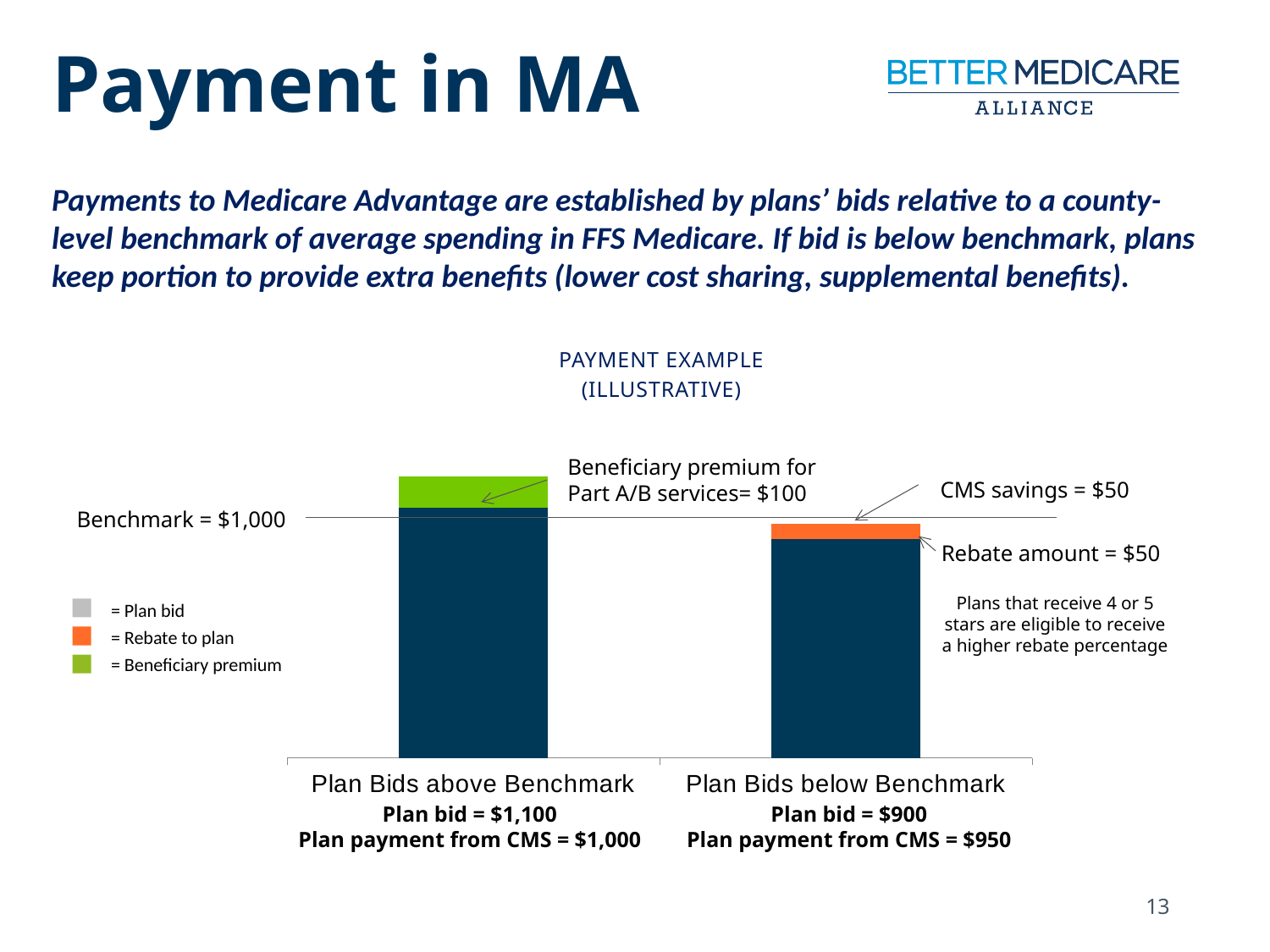
What is the title of the chart? PAYMENT EXAMPLE (ILLUSTRATIVE) What kind of chart is shown on the slide? Stacked bar chart How many entries does the chart's legend list? 3 What is the plan bid for the 'Plan Bids below Benchmark' category? $900 What is the benchmark value shown on the chart? $1,000 What is the rebate amount shown for the 'Plan Bids below Benchmark' category? $50 What is the beneficiary premium for Part A/B services shown on the chart? $100 What is the plan payment from CMS for the 'Plan Bids below Benchmark' category? $950 What is the difference between the plan bids of the two categories? $200 How many categories are shown on the x axis of the chart? 2 Which category has the higher plan bid, 'Plan Bids above Benchmark' or 'Plan Bids below Benchmark'? Plan Bids above Benchmark What is the plan bid for the 'Plan Bids above Benchmark' category? $1,100